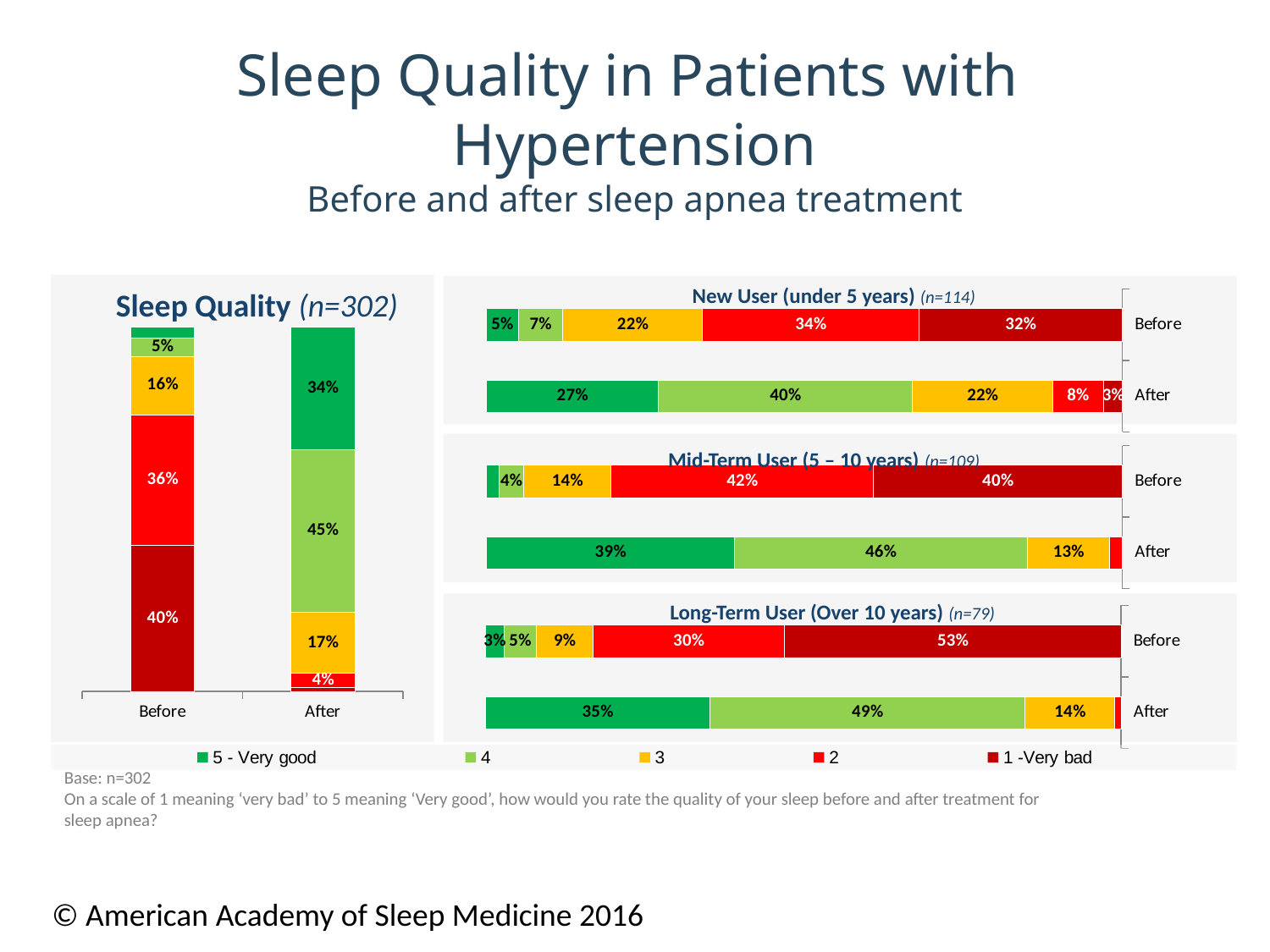
In the New User (under 5 years) chart, which rating has the largest share after treatment? 4 In the Long-Term User (Over 10 years) chart, which rating has the larger share before treatment: '1 - Very bad' or '2'? 1 - Very bad In the Sleep Quality (n=302) chart, what percentage of patients rated their sleep '1 - Very bad' before treatment? 40% In the Mid-Term User (5 – 10 years) chart, what percentage of patients rated their sleep '5 - Very good' after treatment? 39% How many series does the legend at the bottom of the slide list? 5 In the New User (under 5 years) chart, what is the total of the labelled segments in the Before bar? 100% In the Long-Term User (Over 10 years) chart, what percentage of patients rated their sleep '1 - Very bad' before treatment? 53% In the Sleep Quality (n=302) chart, what is the difference in percentage points between the '2' rating before treatment and the '2' rating after treatment? 32 percentage points What sample size is shown in the title of the Mid-Term User (5 – 10 years) chart? n=109 In the Sleep Quality (n=302) chart, what percentage of patients gave a rating of '4' after treatment? 45% In the New User (under 5 years) chart, what percentage of patients gave a rating of '2' before treatment? 34% What kind of chart is the Sleep Quality (n=302) chart on the left of the slide? Stacked bar chart